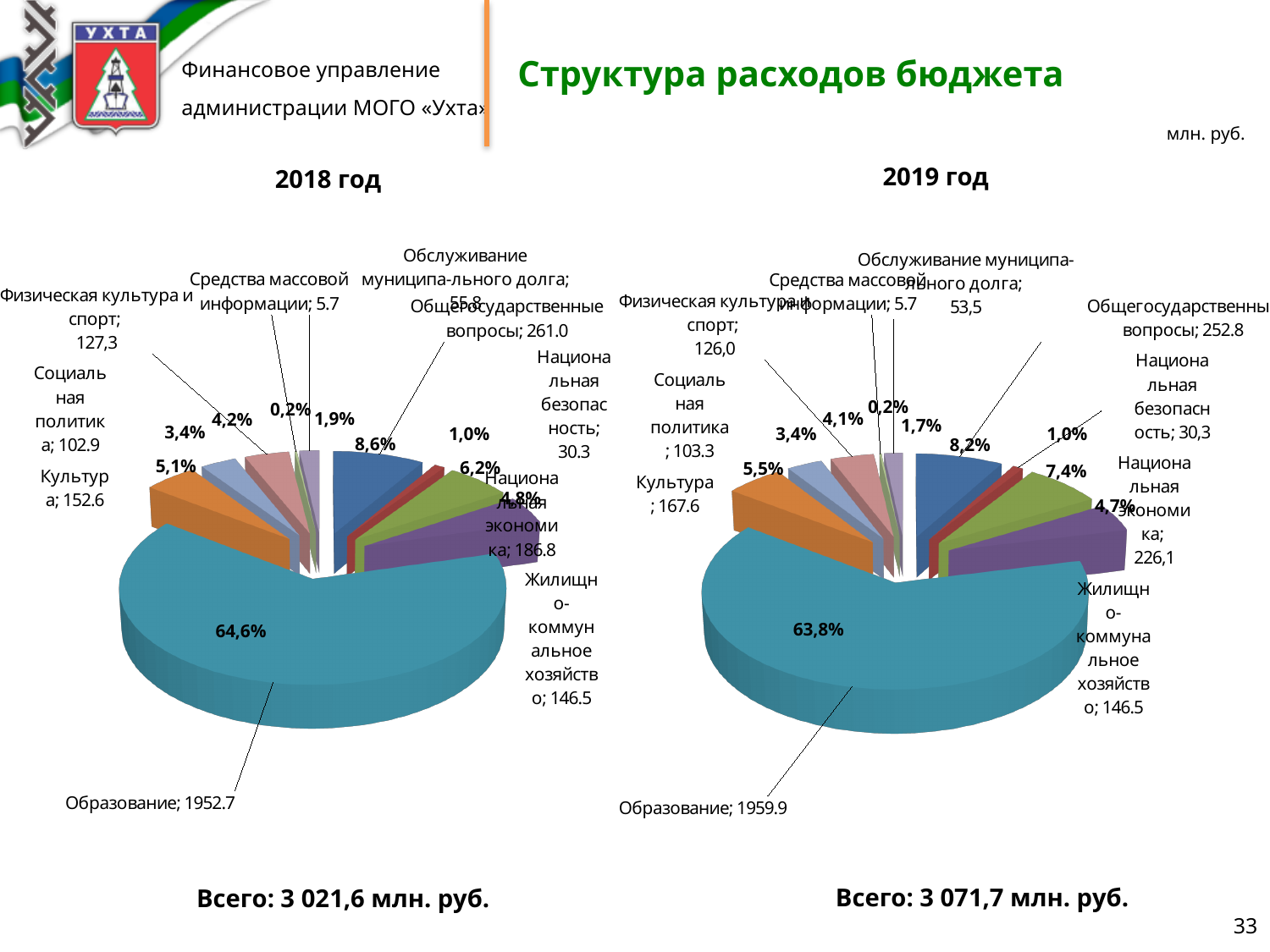
In the 2019 год chart, what is the value for Национальная экономика? 226,1 What kind of chart is used for the 2018 год data? Pie chart In the 2019 год chart, what share of the pie does Общегосударственные вопросы take? 8,2% In the 2019 год chart, which is larger: Культура or Социальная политика? Культура In the 2019 год chart, what is the value for Образование? 1959.9 How many categories are shown in the 2019 год chart? 10 In the 2018 год chart, what share of the pie does Образование take? 64,6% In the 2018 год chart, what is the value for Культура? 152.6 In the 2018 год chart, which category has the largest slice? Образование In the 2018 год chart, what is the value for Образование? 1952.7 What is the difference between the Культура values in the 2019 год chart and the 2018 год chart? 15.0 In the 2019 год chart, which category has the smallest slice? Средства массовой информации